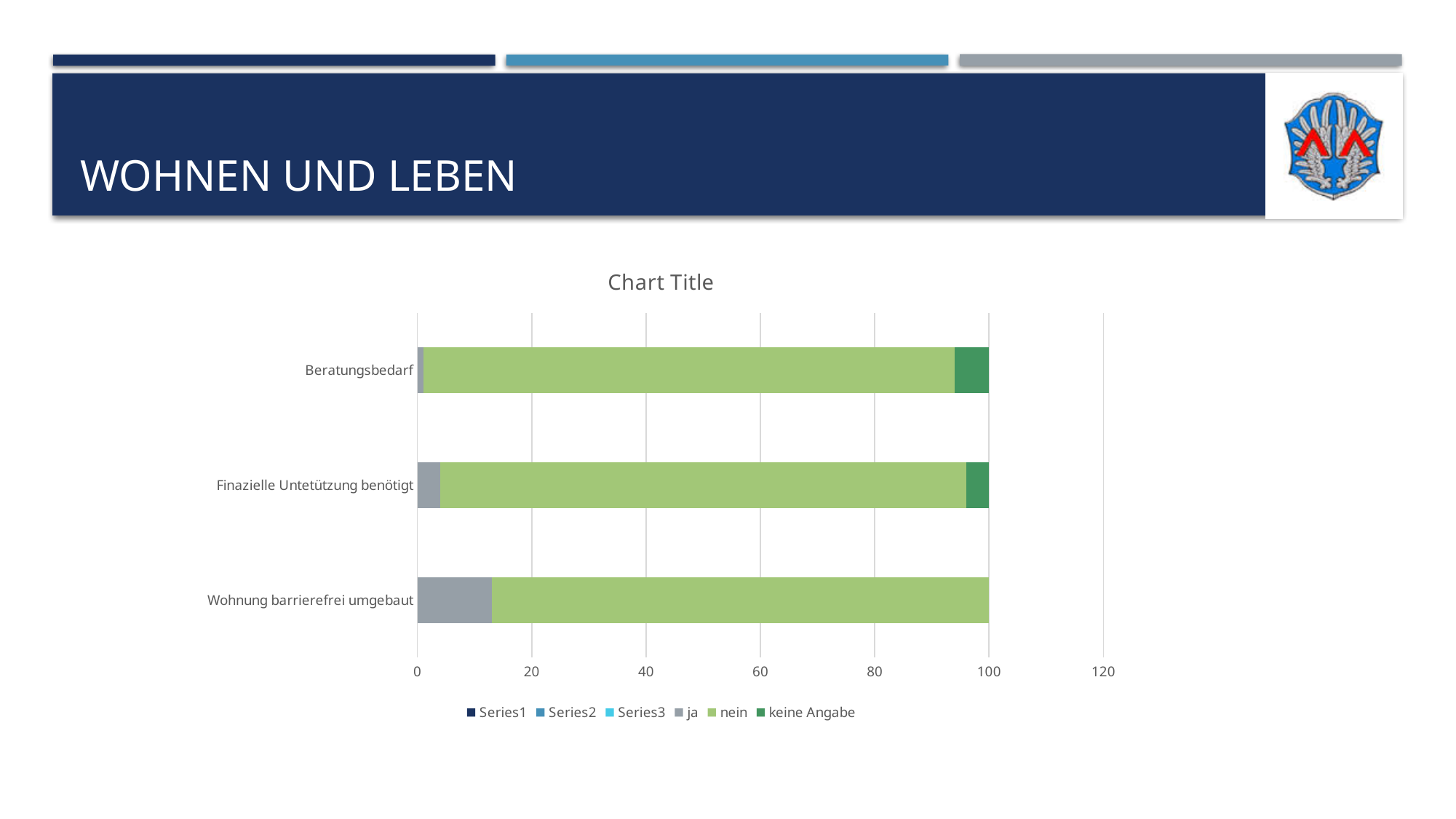
Is the 'ja' value for 'Finazielle Untetützung benötigt' greater or less than 20? less What kind of chart is shown on the slide? bar chart Is the 'nein' value for 'Beratungsbedarf' greater or less than 80? greater Is the 'ja' value for 'Wohnung barrierefrei umgebaut' greater or less than 20? less Which category has no 'keine Angabe' segment? Wohnung barrierefrei umgebaut Is the 'keine Angabe' segment larger for 'Beratungsbedarf' or for 'Finazielle Untetützung benötigt'? Beratungsbedarf What is the total of the stacked bar for 'Beratungsbedarf'? 100 What is the title of the chart? Chart Title How many series does the chart legend list? 6 Which category has the smallest 'ja' segment? Beratungsbedarf Which category has the largest 'ja' segment? Wohnung barrierefrei umgebaut How many categories are shown on the vertical axis of the chart? 3